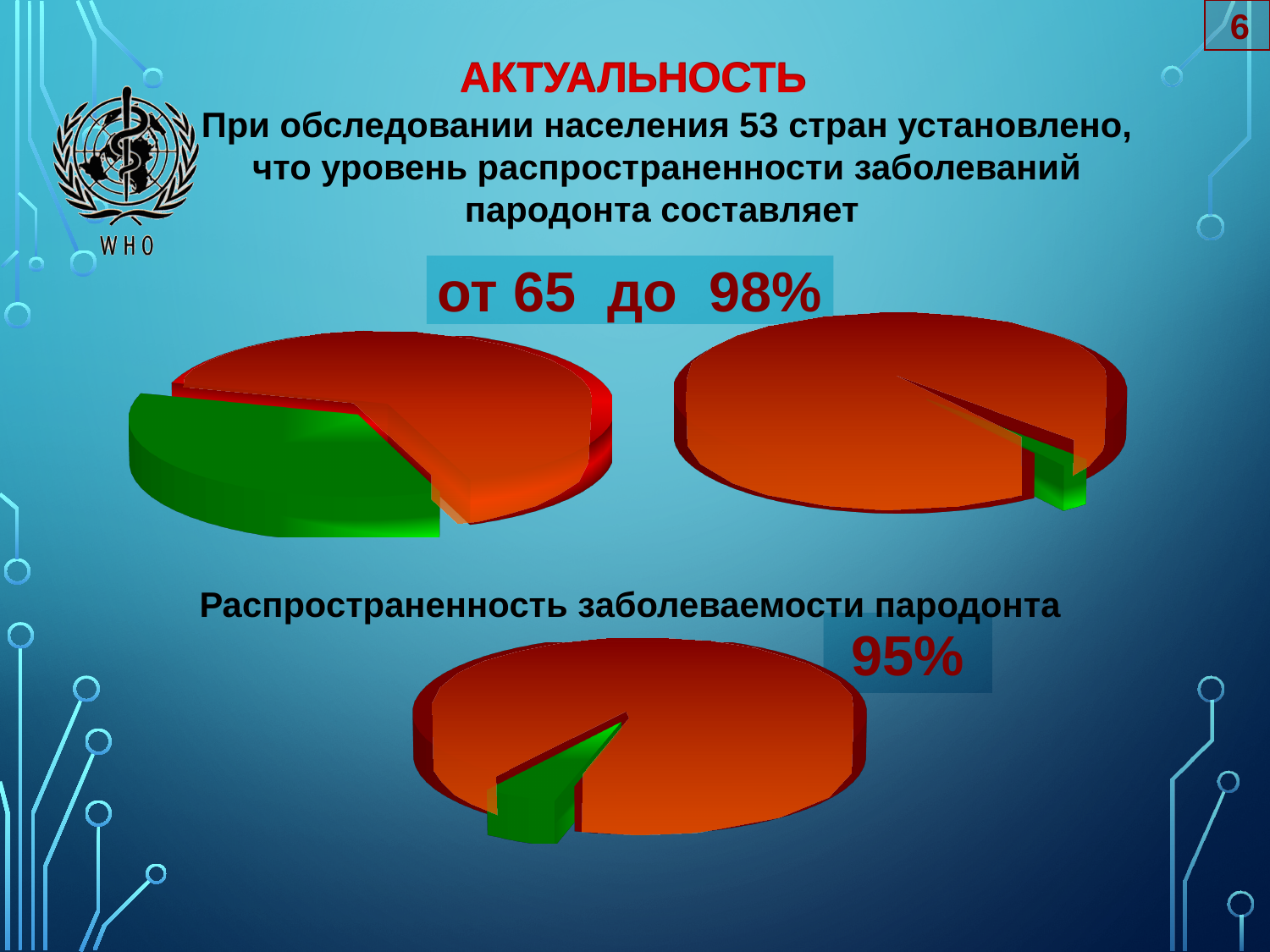
What kind of chart is the bottom chart on the slide? pie chart What caption is written above the bottom pie chart? Распространенность заболеваемости пародонта How many pie charts are shown on the slide? 3 How many slices does the bottom pie chart have? 2 What percentage is printed next to the bottom pie chart? 95% In the top-right pie chart, which slice is larger, the red one or the green one? red Which of the three pie charts has the largest green slice? the top-left chart In the bottom pie chart, which slice is smaller, the red one or the green one? green In the top-left pie chart, which slice is larger, the red one or the green one? red What kind of chart is the top-left chart on the slide? pie chart Which of the three pie charts has the smallest green slice? the top-right chart How many slices does the top-right pie chart have? 2